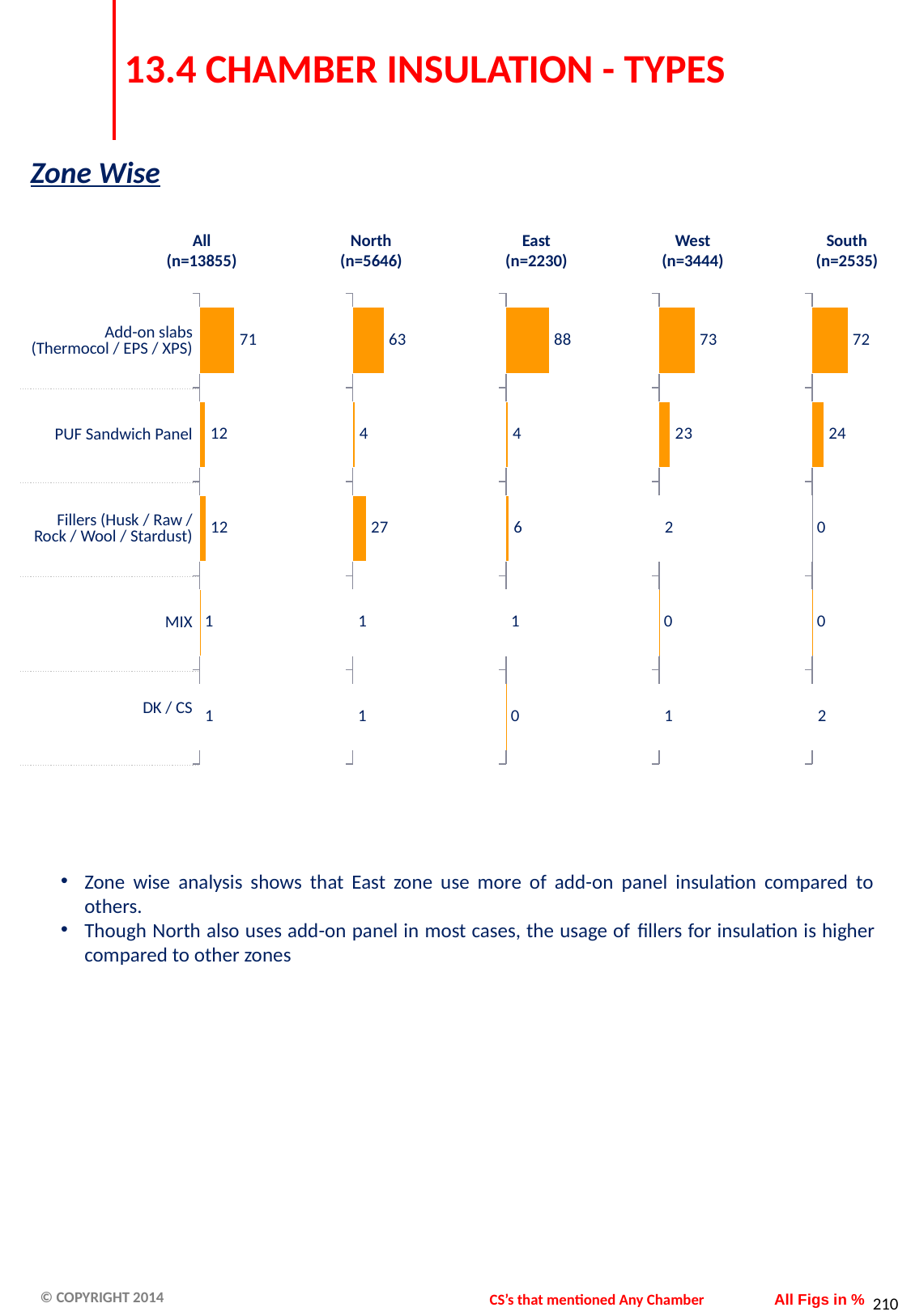
In the South (n=2535) chart, what is the value for PUF Sandwich Panel? 24 What type of chart is used for each zone? Bar chart What is the difference between the Add-on slabs value in the East (n=2230) chart and the Add-on slabs value in the North (n=5646) chart? 25 In the All (n=13855) chart, what is the value for DK / CS? 1 In the North (n=5646) chart, what is the value for Fillers (Husk / Raw / Rock / Wool / Stardust)? 27 In the West (n=3444) chart, what is the difference between the PUF Sandwich Panel value and the Fillers value? 21 In the North (n=5646) chart, which category has the lowest value? MIX and DK / CS (both 1) In the East (n=2230) chart, what is the value for Add-on slabs (Thermocol / EPS / XPS)? 88 How many zone charts are shown on the slide? 5 How many categories are shown in each zone chart? 5 In the West (n=3444) chart, which category has the highest value? Add-on slabs (Thermocol / EPS / XPS) Which is larger: the PUF Sandwich Panel value in the West (n=3444) chart or in the All (n=13855) chart? West (n=3444)